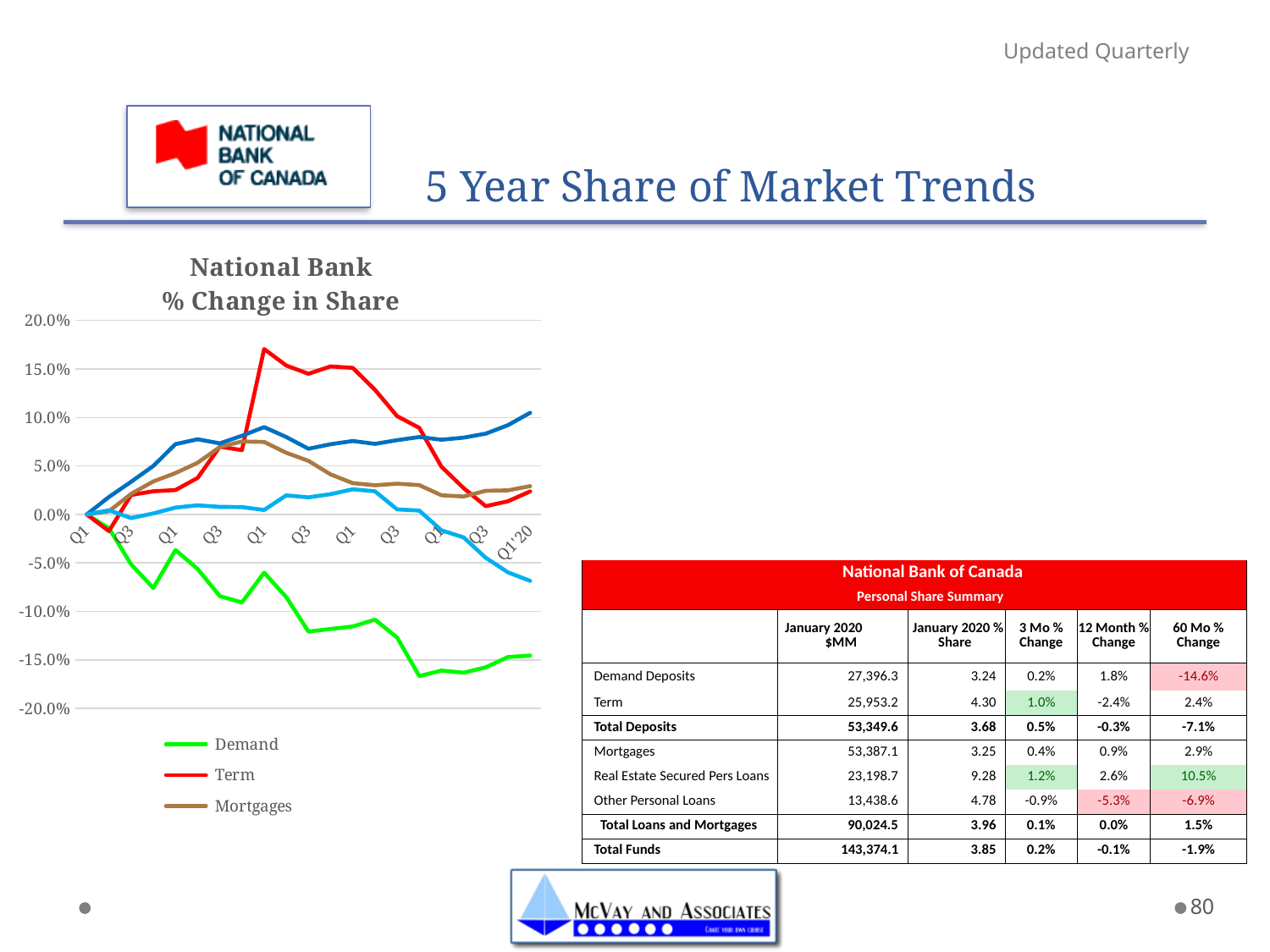
Is the value for Mortgages at Q1'20 greater or less than 0.0%? greater What is the title of the chart? National Bank % Change in Share Does the Demand line overall rise or fall from the first Q1 to Q1'20? fall What kind of chart is shown on the slide? line chart How many series does the chart legend list? 3 Which series in the legend is drawn in green? Demand Which legend series has the lowest value at Q1'20? Demand Is the value for Demand at Q1'20 greater or less than -10.0%? less At Q1'20, is the value for Term larger or smaller than the value for Demand? larger Is the peak value of the Term line greater or less than 15.0%? greater Which legend series reaches the highest value anywhere on the chart? Term